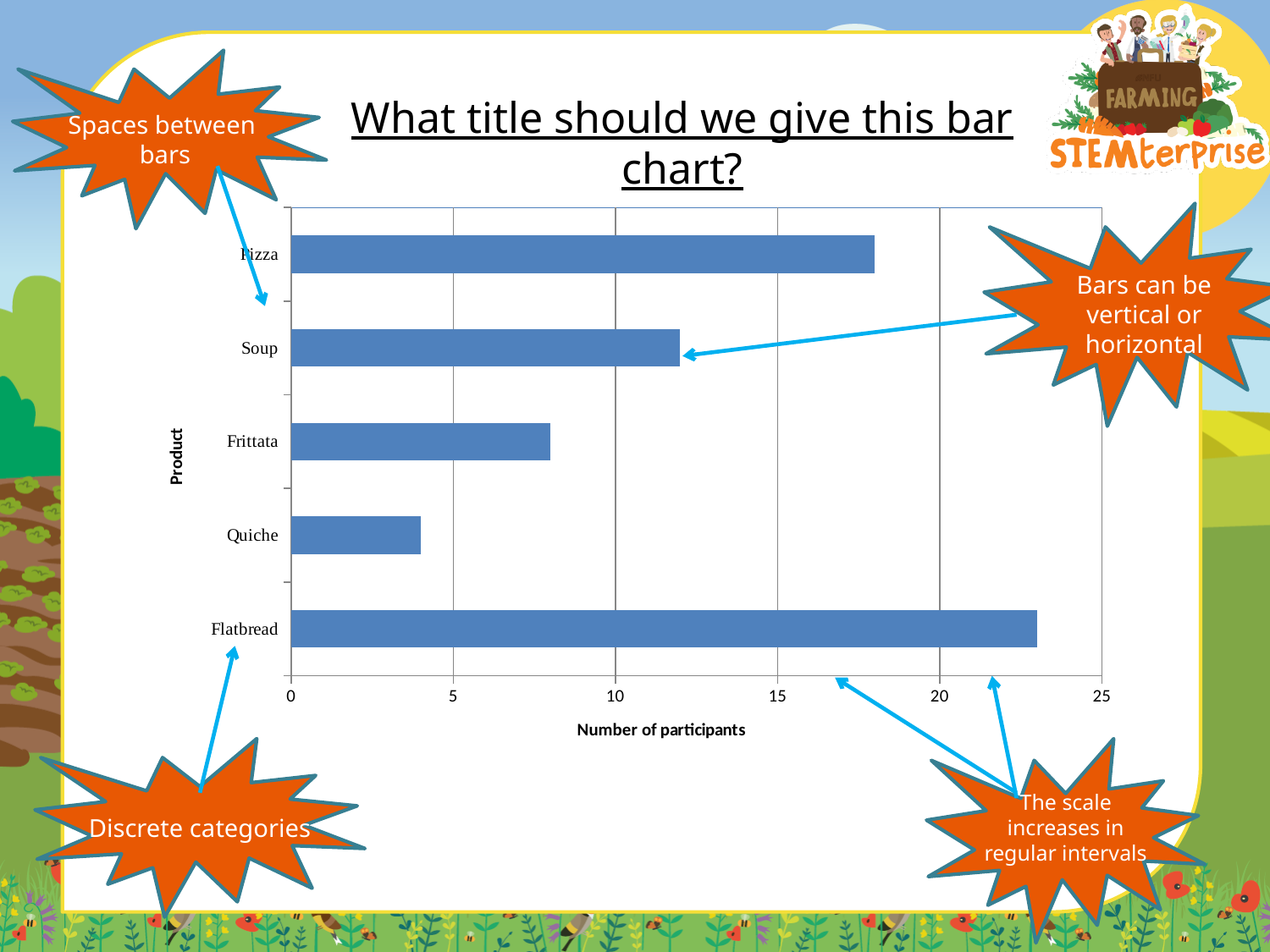
Which product has the highest number of participants? Flatbread Is the value for Soup greater or less than 10? greater What is the title of the horizontal axis? Number of participants How many products are shown on the chart? 5 Which has more participants, Pizza or Soup? Pizza Is the value for Quiche greater or less than 5? less Is the value for Flatbread greater or less than 20? greater Which product has the lowest number of participants? Quiche What is the title of the vertical axis? Product Which has more participants, Frittata or Quiche? Frittata What kind of chart is shown on the slide? bar chart